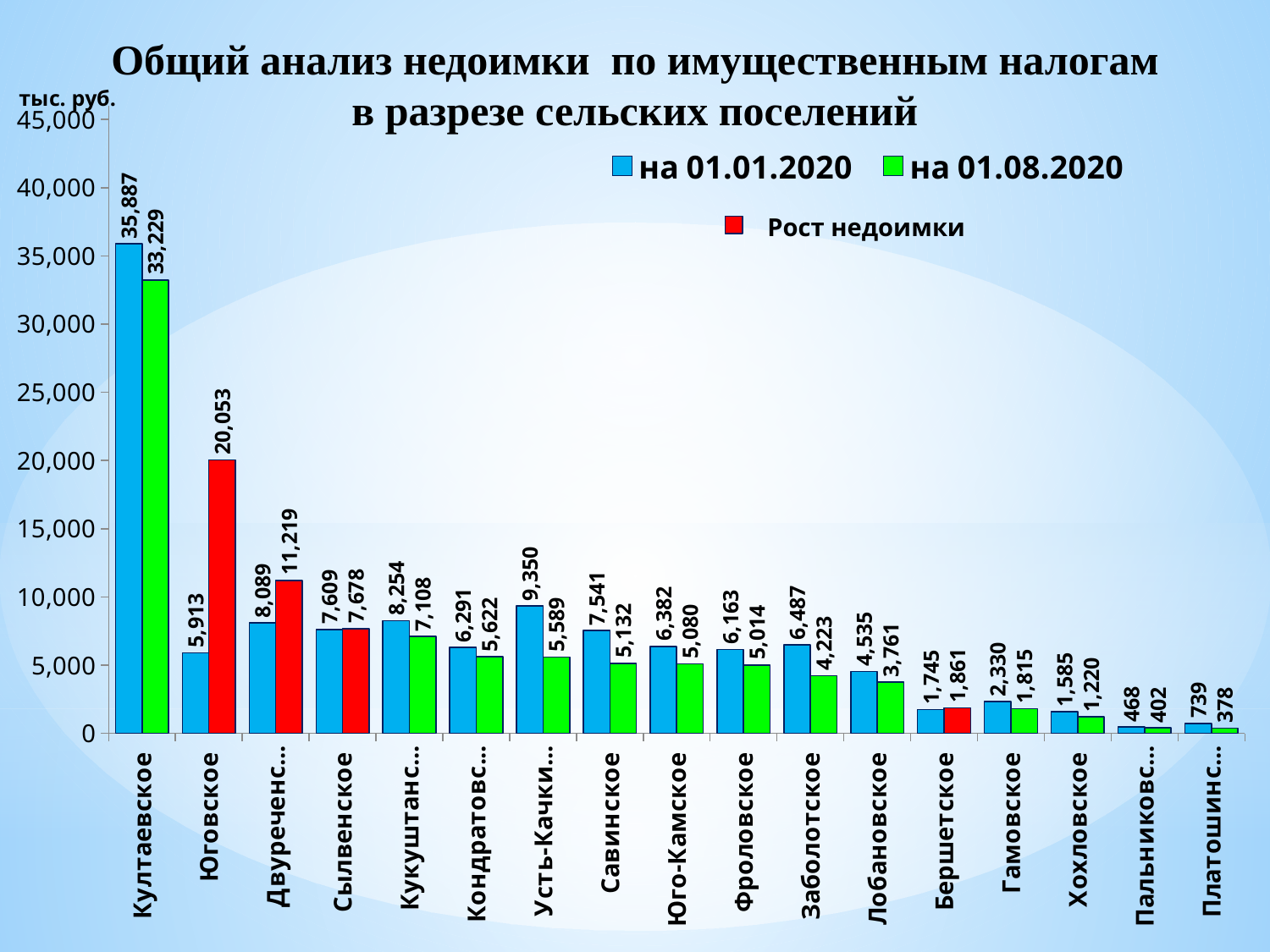
What is the value for Савинское in the series 'на 01.01.2020'? 7,541 What is the value for Юговское in the series 'на 01.08.2020'? 20,053 Is the value for Юговское in the series 'на 01.08.2020' greater or less than 15,000? greater Which category has the highest value in the series 'на 01.01.2020'? Култаевское What unit is indicated at the top of the vertical axis? тыс. руб. What is the difference between the 'на 01.01.2020' and 'на 01.08.2020' values for Култаевское? 2,658 Which category has the lowest value in the series 'на 01.08.2020'? Платошинс... How many entries does the legend list? 3 Which is larger for Бершетское: the value 'на 01.01.2020' or 'на 01.08.2020'? на 01.08.2020 How many categories are shown on the x axis? 17 What is the value for Култаевское in the series 'на 01.01.2020'? 35,887 What kind of chart is shown on the slide? bar chart